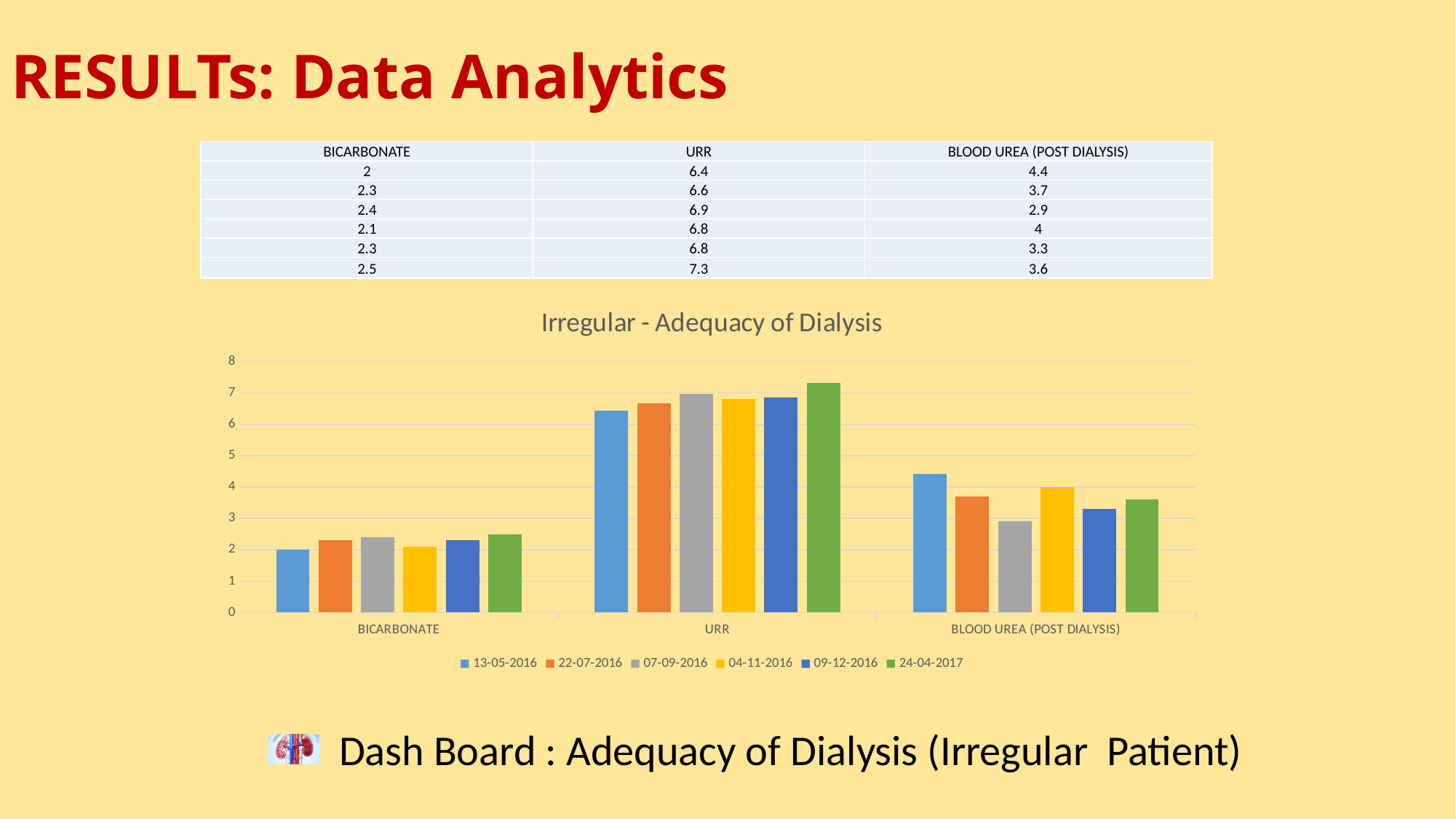
Which series is shown in green in the chart legend? 24-04-2017 Do the URR values generally rise or fall from 13-05-2016 to 24-04-2017? rise What is the title of the chart? Irregular - Adequacy of Dialysis What kind of chart is shown on the slide? bar chart Which category has the tallest bars in the chart? URR For BLOOD UREA (POST DIALYSIS), which is larger: the value for 13-05-2016 or the value for 07-09-2016? 13-05-2016 How many categories are shown on the x axis of the chart? 3 Which category has the shortest bars in the chart? BICARBONATE Is the value for BICARBONATE on 13-05-2016 greater or less than 3? less Is the value for URR on 24-04-2017 greater or less than 7? greater Is the value for BLOOD UREA (POST DIALYSIS) on 07-09-2016 greater or less than 3? less How many series does the chart legend list? 6